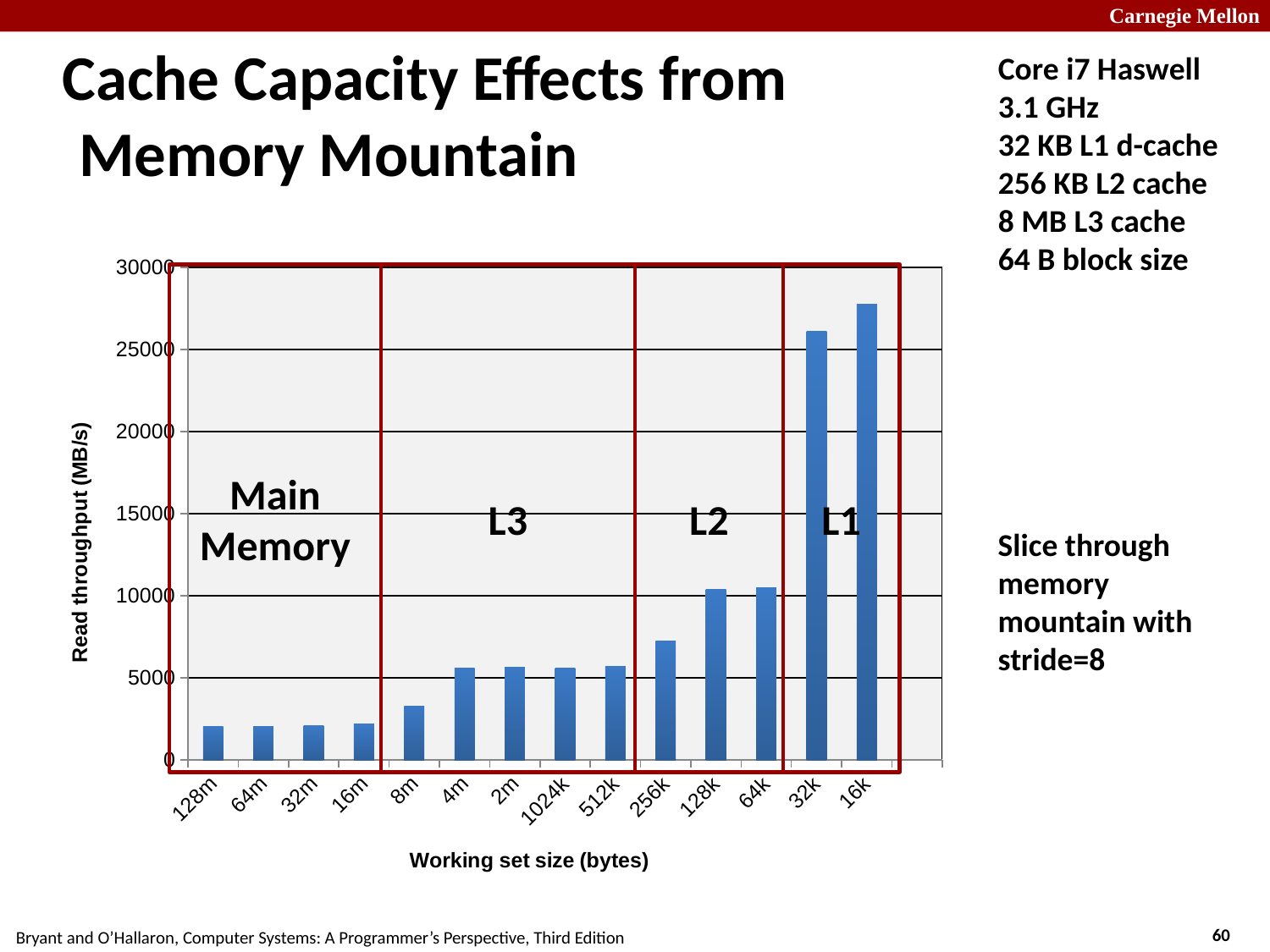
Is the read throughput for a working set size of 8m greater or less than 5000? less What kind of chart is shown on the slide? bar chart What is the label of the y axis? Read throughput (MB/s) Which working set size has the highest read throughput? 16k How many working set sizes are plotted along the x axis? 14 Do the read throughput values generally rise or fall moving from left to right along the x axis? rise Is the read throughput for a working set size of 256k greater or less than 10000? less Is the read throughput for a working set size of 128m greater or less than 5000? less Which has the higher read throughput, a working set size of 256k or 512k? 256k Which has the higher read throughput, a working set size of 8m or 4m? 4m